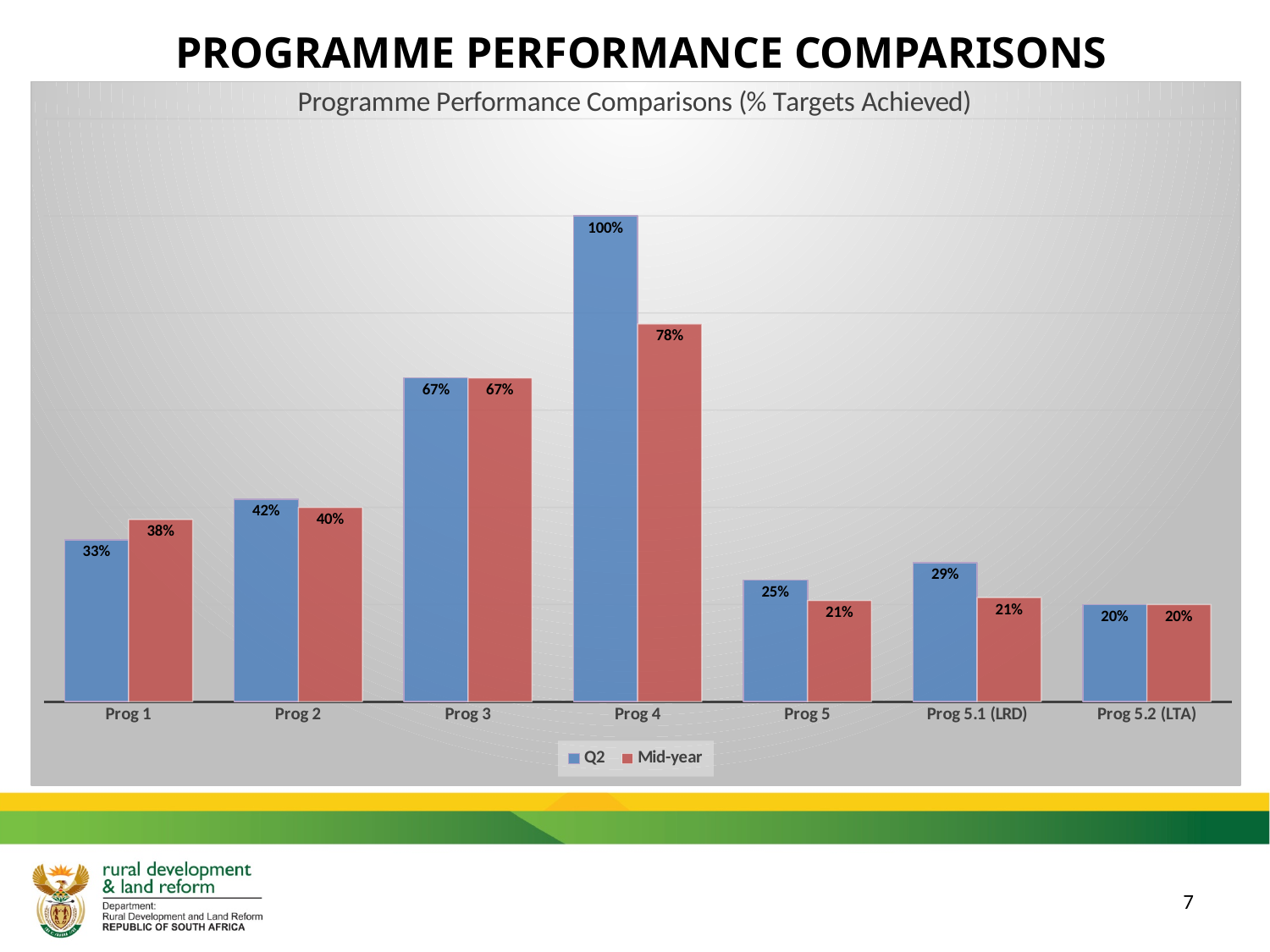
What is the Mid-year value for Prog 5.1 (LRD)? 21% Which colour represents the Mid-year series? Red What is the title of the chart? Programme Performance Comparisons (% Targets Achieved) What kind of chart is shown on the slide? Bar chart What is the Q2 value for Prog 4? 100% What is the Mid-year value for Prog 1? 38% How many programmes are shown on the x axis? 7 Which is larger for Prog 1, the Q2 value or the Mid-year value? Mid-year What is the difference between the Q2 and Mid-year values for Prog 4? 22% Which programme has the lowest Mid-year value? Prog 5.2 (LTA) Which programme has the highest Q2 value? Prog 4 How many series does the legend list? 2